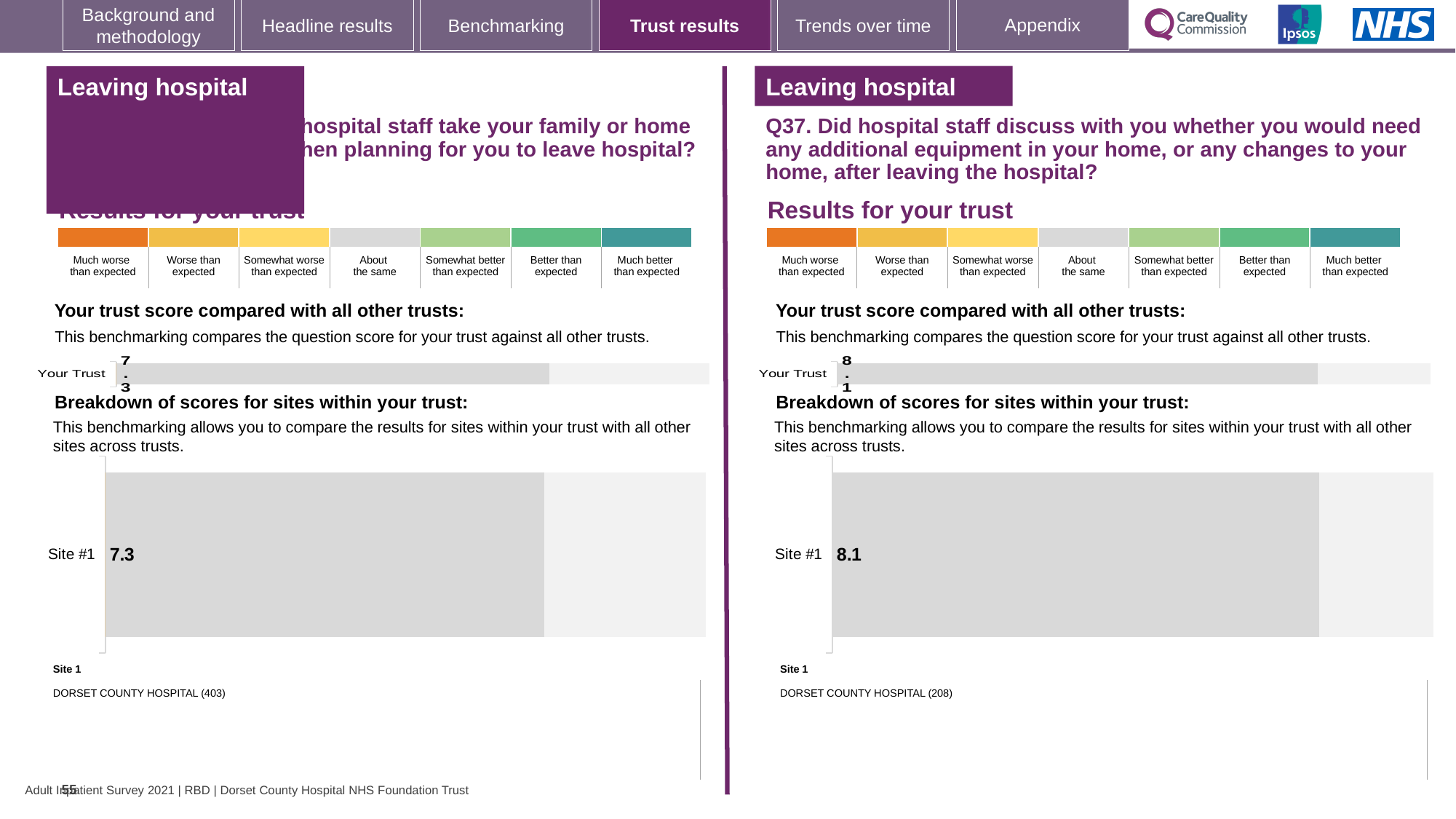
Is the Site #1 score in the left-hand chart greater or less than the Site #1 score in the right-hand chart (Q37)? less In the right-hand site breakdown chart (Q37), what is the score for Site #1? 8.1 Which is larger: the Your Trust score on the left half of the slide or the Your Trust score on the right half (Q37)? Right half (Q37), 8.1 What is the difference between the Site #1 score in the right-hand chart (Q37) and the Site #1 score in the left-hand chart? 0.8 On the right half of the slide (Q37), what is the score shown for Your Trust? 8.1 Which site name is listed under Site 1 in the right-hand chart (Q37)? DORSET COUNTY HOSPITAL (208) Which site name is listed under Site 1 in the left-hand chart? DORSET COUNTY HOSPITAL (403) On the left half of the slide, what is the score shown for Your Trust? 7.3 How many sites are shown in the left-hand site breakdown chart? 1 In the left-hand site breakdown chart, what is the score for Site #1? 7.3 What type of chart is used for the site breakdown on the right half of the slide (Q37)? Bar chart How many sites are shown in the right-hand site breakdown chart (Q37)? 1